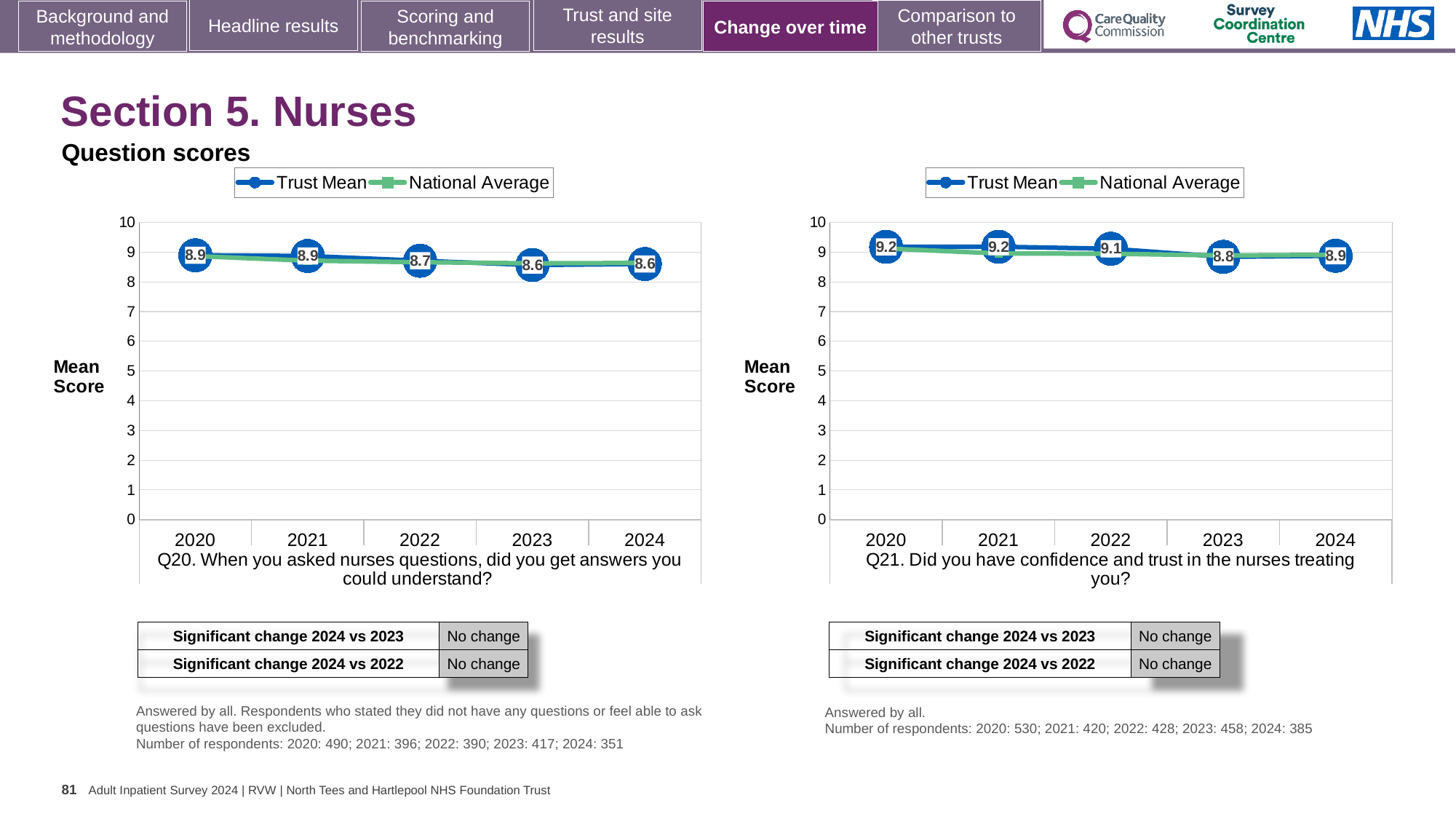
In the Q21 chart on the right, what is the difference between the Trust Mean scores for 2022 and 2023? 0.3 How many years are shown on the x axis of the Q20 chart on the left? 5 In the Q21 chart on the right, which year has the lowest Trust Mean score? 2023 How many series does the legend of the Q21 chart on the right list? 2 In the Q20 chart on the left, what is the Trust Mean score for 2022? 8.7 In the Q20 chart on the left, what is the Trust Mean score for 2024? 8.6 What type of chart is the Q20 chart on the left? Line chart In the Q21 chart on the right, what is the Trust Mean score for 2020? 9.2 In the Q21 chart on the right, is the Trust Mean value for 2024 greater or less than 8? greater In the Q21 chart on the right, what is the Trust Mean score for 2023? 8.8 In the Q20 chart on the left, what is the difference between the Trust Mean scores for 2020 and 2024? 0.3 In the Q20 chart on the left, is the Trust Mean score for 2020 larger or smaller than the score for 2023? larger